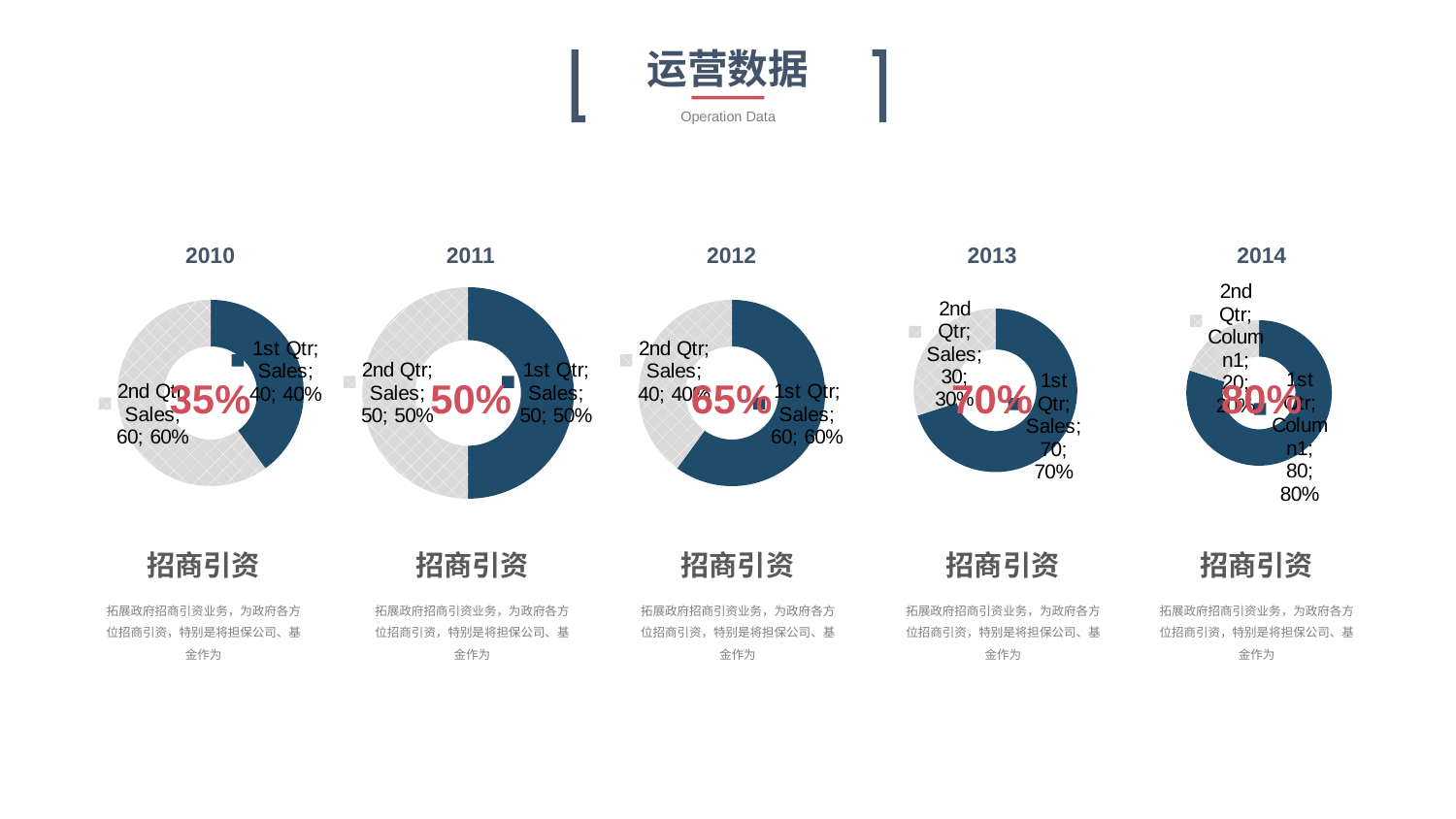
In the 2012 chart, what percentage share does 1st Qtr have? 60% What large percentage is printed in the centre of the 2012 chart? 65% In the 2014 chart, what percentage share does 1st Qtr have? 80% In the 2010 chart, what is the value for 1st Qtr? 40 How many slices does the 2013 chart have? 2 In the 2013 chart, what is the value for 2nd Qtr? 30 In the 2011 chart, what is the value for 2nd Qtr? 50 In the 2013 chart, which slice is larger, 1st Qtr or 2nd Qtr? 1st Qtr In the 2014 chart, what is the difference between the 1st Qtr and 2nd Qtr values? 60 In the 2010 chart, what percentage share does 2nd Qtr have? 60% What kind of chart is used for the 2011 data? Doughnut chart In the 2012 chart, which slice is the smallest? 2nd Qtr